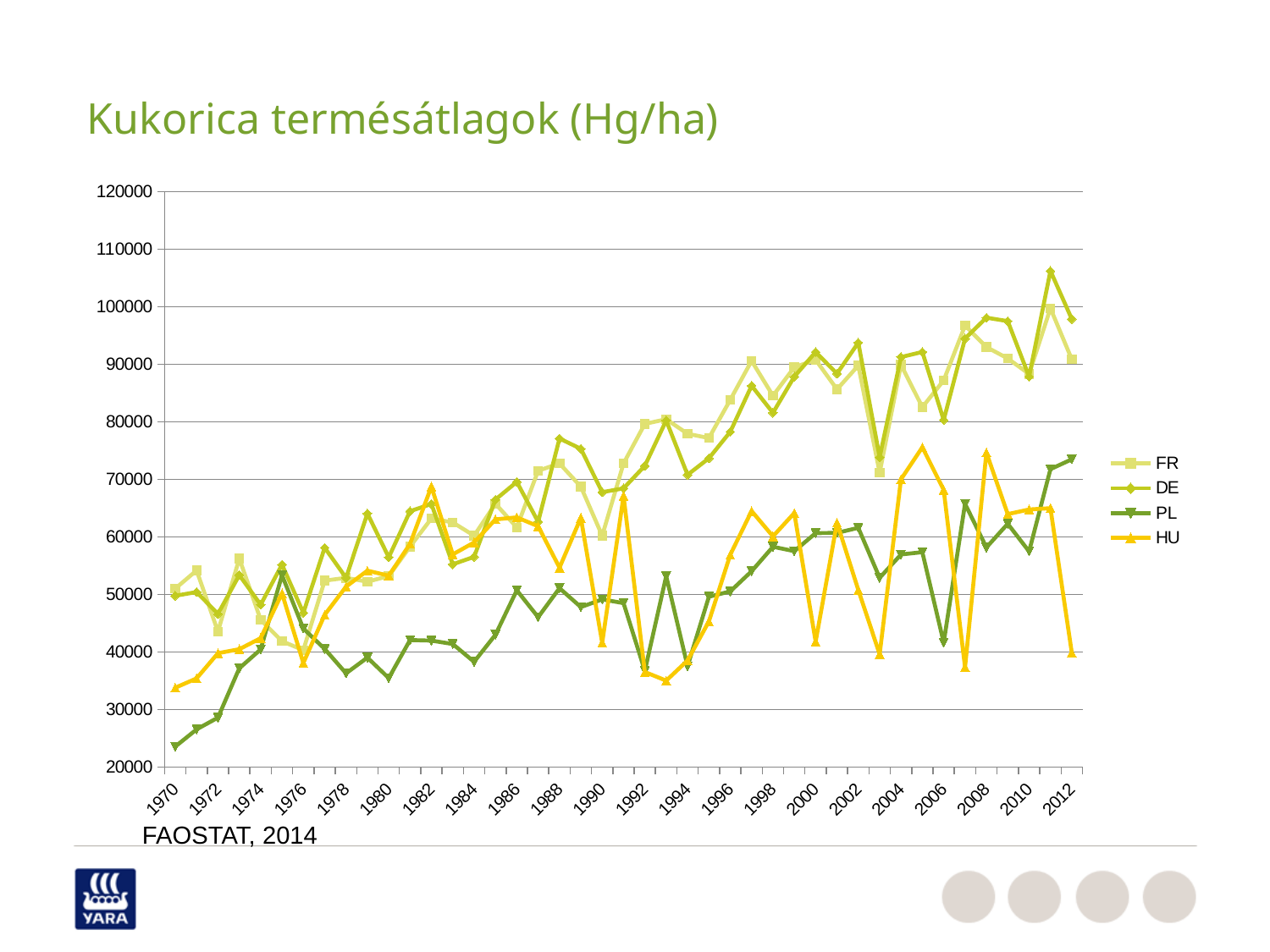
Which series has the lowest value in 1970? PL Is the value for DE in 2011 greater or less than 100000? greater Which series has the highest value in 2011? DE Is the value for PL in 1970 greater or less than 30000? less Does the PL series generally rise or fall from 1970 to 2012? rise In 1993, which is larger, the value for PL or the value for HU? PL In 2012, which is larger, the value for DE or the value for HU? DE Is the value for HU in 2012 greater or less than 50000? less What are the series names listed in the legend? FR, DE, PL, HU How many series does the legend list? 4 What kind of chart is shown on the slide? line chart What is the title of the chart? Kukorica termésátlagok (Hg/ha)